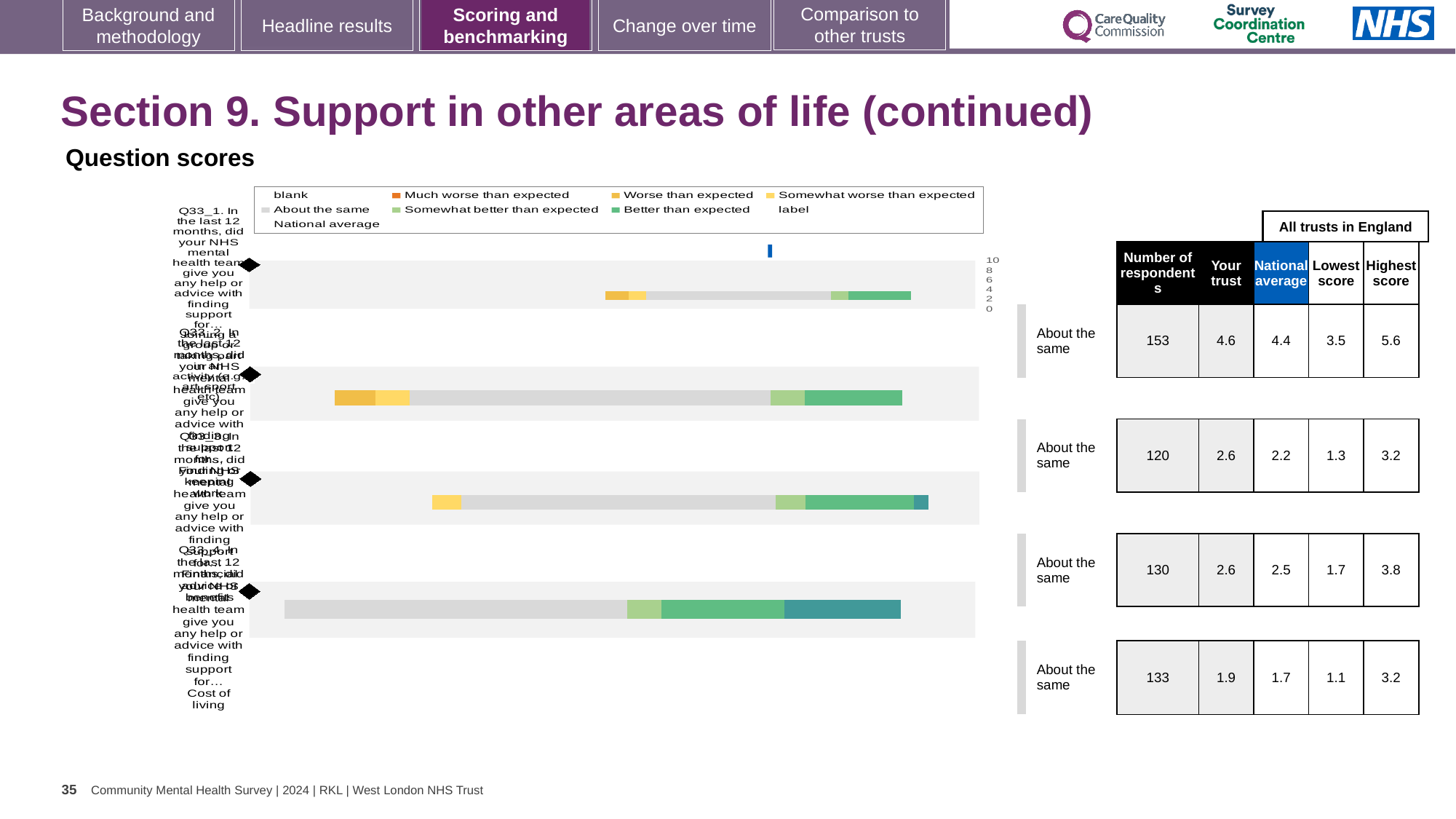
Which question row has the highest 'Your trust' score in the table? Q33_1 (first row), 4.6 In the table, what is the highest score for the second question row? 3.2 In the table, what is the national average for the last question (Cost of living)? 1.7 Which question row has the lowest 'Your trust' score in the table? Cost of living (last row), 1.9 In the table, what is the number of respondents for the first question (Q33_1)? 153 For the second question row, which is larger: the 'Your trust' score or the national average? Your trust In the table, what is the 'Your trust' score for the first question (Q33_1)? 4.6 What benchmark label is shown next to each of the four question bars? About the same How many questions (bars) are plotted in the chart? 4 How many entries does the chart legend list? 9 What kind of chart is shown on the slide? bar chart For the first question (Q33_1), what is the difference between the 'Your trust' score and the national average? 0.2